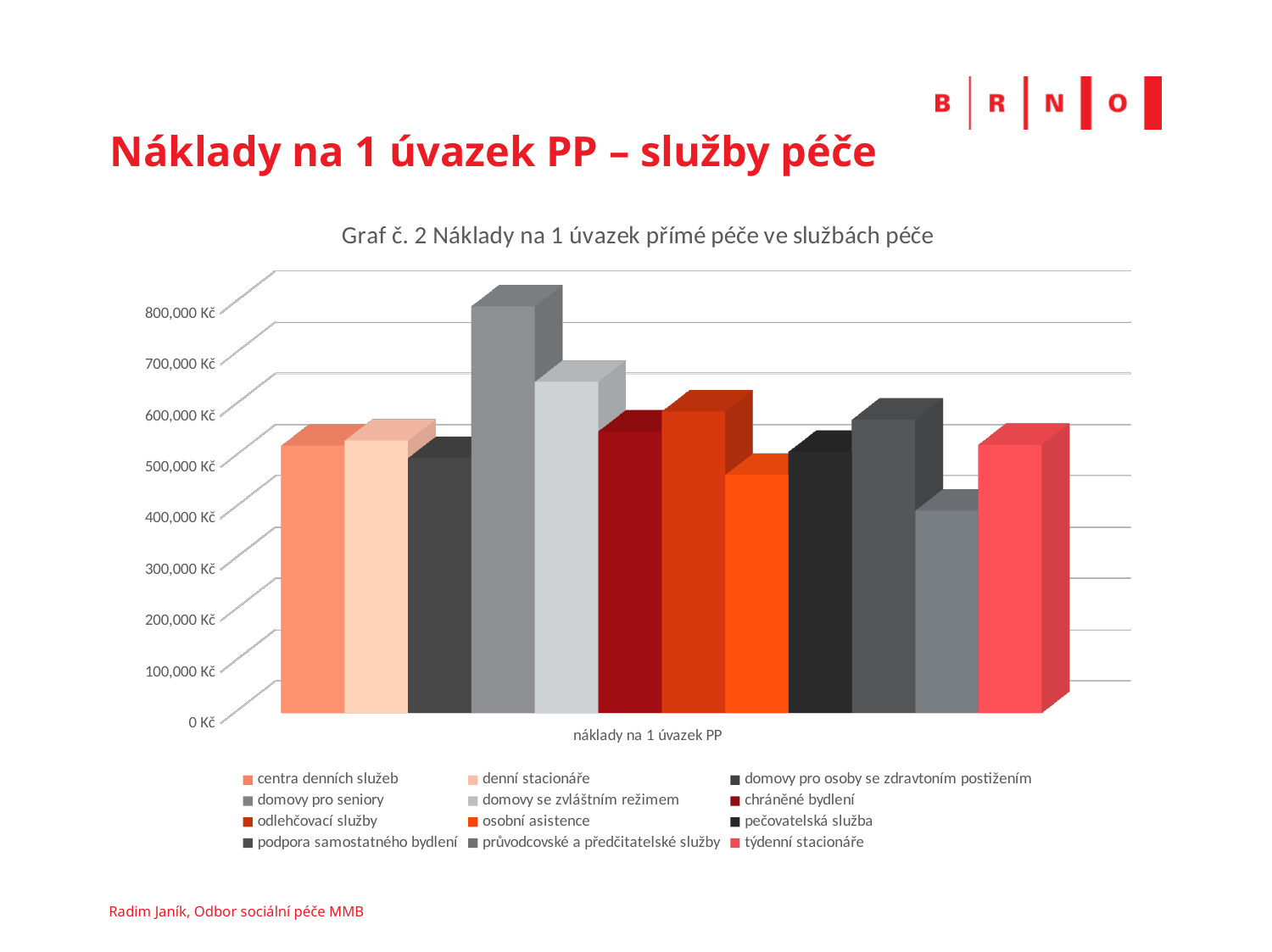
Is the value for průvodcovské a předčitatelské služby greater or less than 500,000 Kč? less Is the value for domovy pro seniory greater or less than 700,000 Kč? greater How many series does the legend list? 12 What is the title of the chart? Graf č. 2 Náklady na 1 úvazek přímé péče ve službách péče Which service has the highest cost per 1 FTE of direct care? domovy pro seniory Which is larger, the value for domovy pro seniory or the value for domovy se zvláštním režimem? domovy pro seniory Which is larger, the value for týdenní stacionáře or the value for průvodcovské a předčitatelské služby? týdenní stacionáře Which service has the lowest cost per 1 FTE of direct care? průvodcovské a předčitatelské služby Which is larger, the value for odlehčovací služby or the value for osobní asistence? odlehčovací služby What kind of chart is shown on the slide? bar chart What is the label of the category on the x axis? náklady na 1 úvazek PP Is the value for domovy se zvláštním režimem greater or less than 600,000 Kč? greater